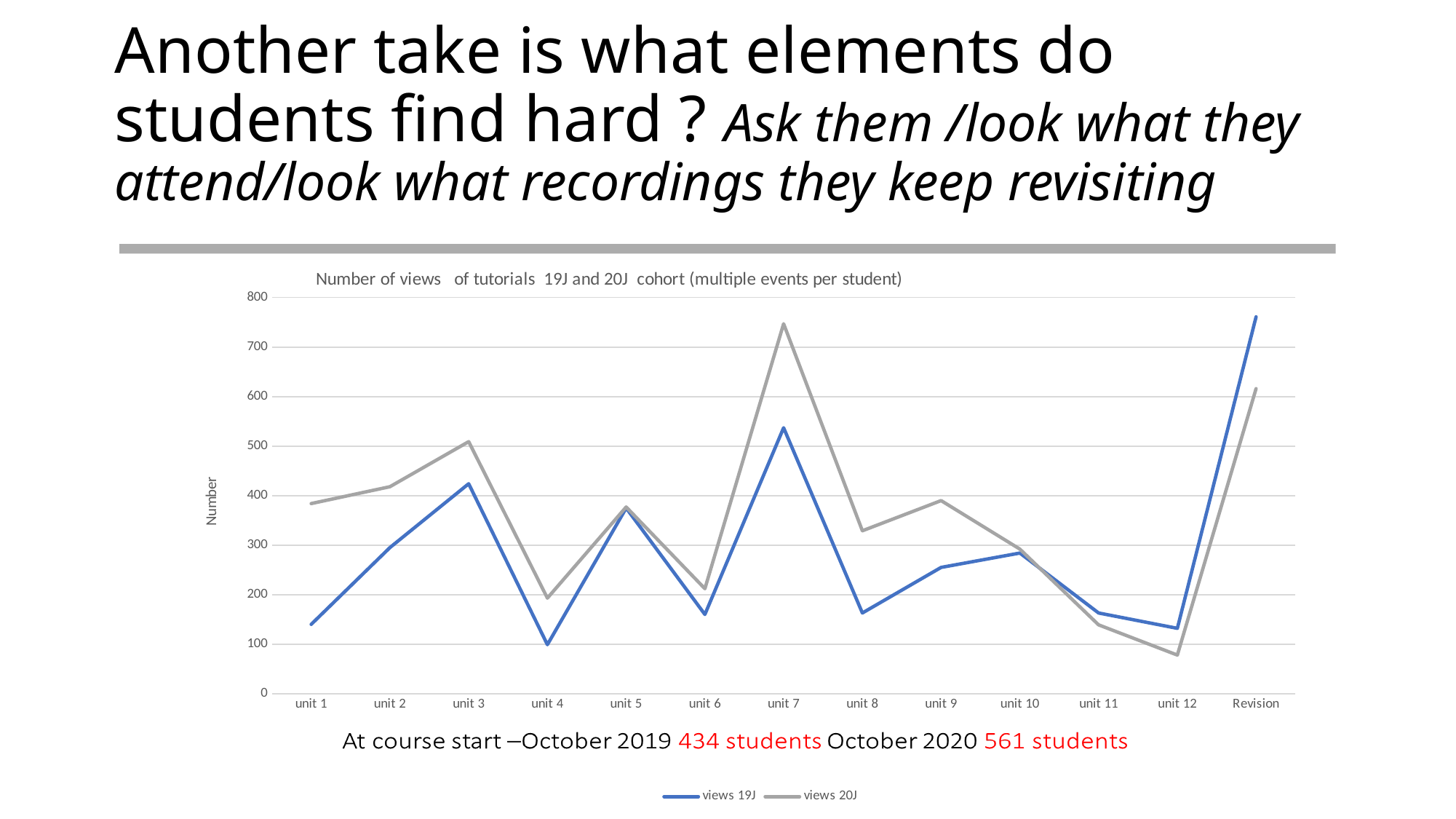
For which category is the views 20J series lowest? unit 12 Does the views 19J series rise or fall from unit 10 to unit 12? fall How many categories are shown on the x axis? 13 For which category is the views 19J series highest? Revision For which category is the views 19J series lowest? unit 4 Is the value for views 20J at unit 7 greater or less than 700? greater How many series does the legend list? 2 What kind of chart is shown on the slide? line chart At unit 7, which series has the larger value, views 19J or views 20J? views 20J For which category is the views 20J series highest? unit 7 Is the value for views 19J at unit 4 greater or less than 200? less At Revision, which series has the larger value, views 19J or views 20J? views 19J